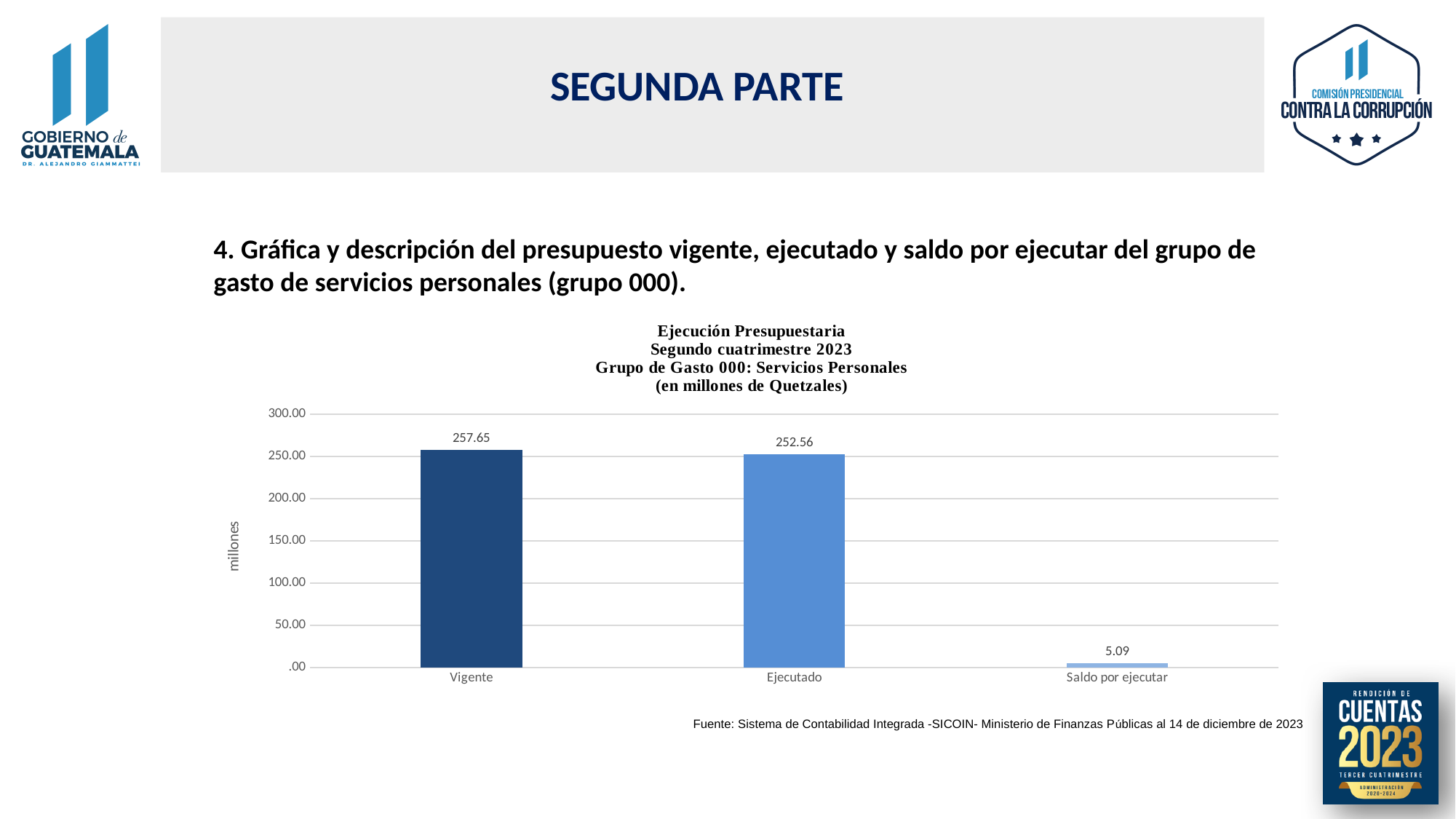
What is the difference between the Vigente and Ejecutado values? 5.09 How many categories are shown on the x axis? 3 Which is larger, the value for Ejecutado or the value for Saldo por ejecutar? Ejecutado What kind of chart is shown on the slide? Bar chart What is the label on the vertical axis of the chart? millones Which category has the lowest value? Saldo por ejecutar What is the value for Vigente? 257.65 What is the value for Saldo por ejecutar? 5.09 Which category has the highest value? Vigente In what unit are the chart values expressed, according to the chart title? millones de Quetzales What is the value for Ejecutado? 252.56 Is the value for Ejecutado greater or less than 200.00? greater